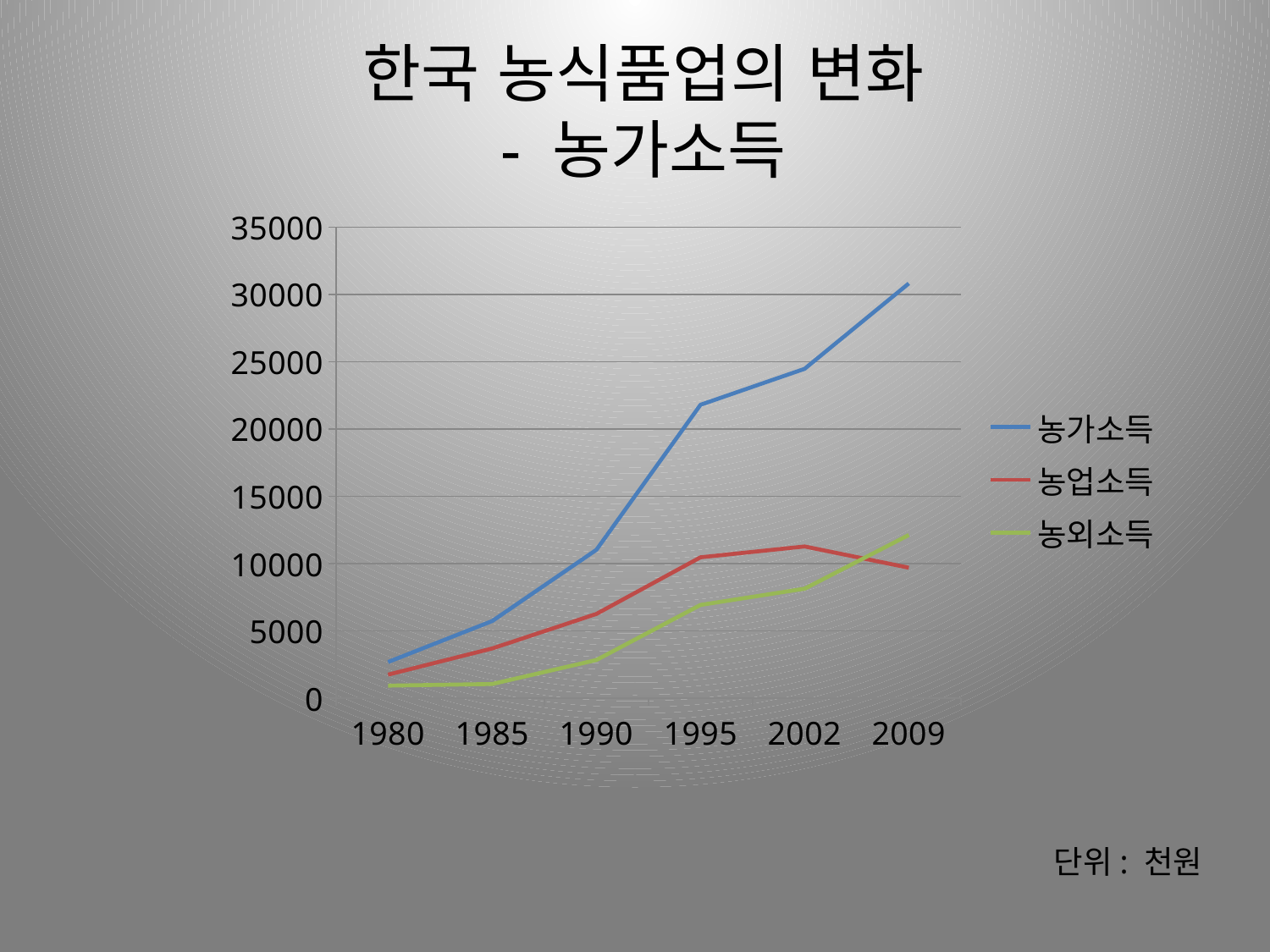
Is the value for 농가소득 in 1995 greater or less than 20000? greater In which year is 농가소득 at its highest? 2009 What unit is stated for the values on the slide? 천원 Which series has the highest value in 2009? 농가소득 In which year is 농업소득 at its highest? 2002 Does 농업소득 rise or fall between 2002 and 2009? fall In 2009, which is larger: 농외소득 or 농업소득? 농외소득 How many series does the legend list? 3 What kind of chart is shown on the slide? line chart How many years are shown on the x axis? 6 Does 농가소득 rise or fall from 1980 to 2009? rise Is the value for 농외소득 in 1980 greater or less than 5000? less